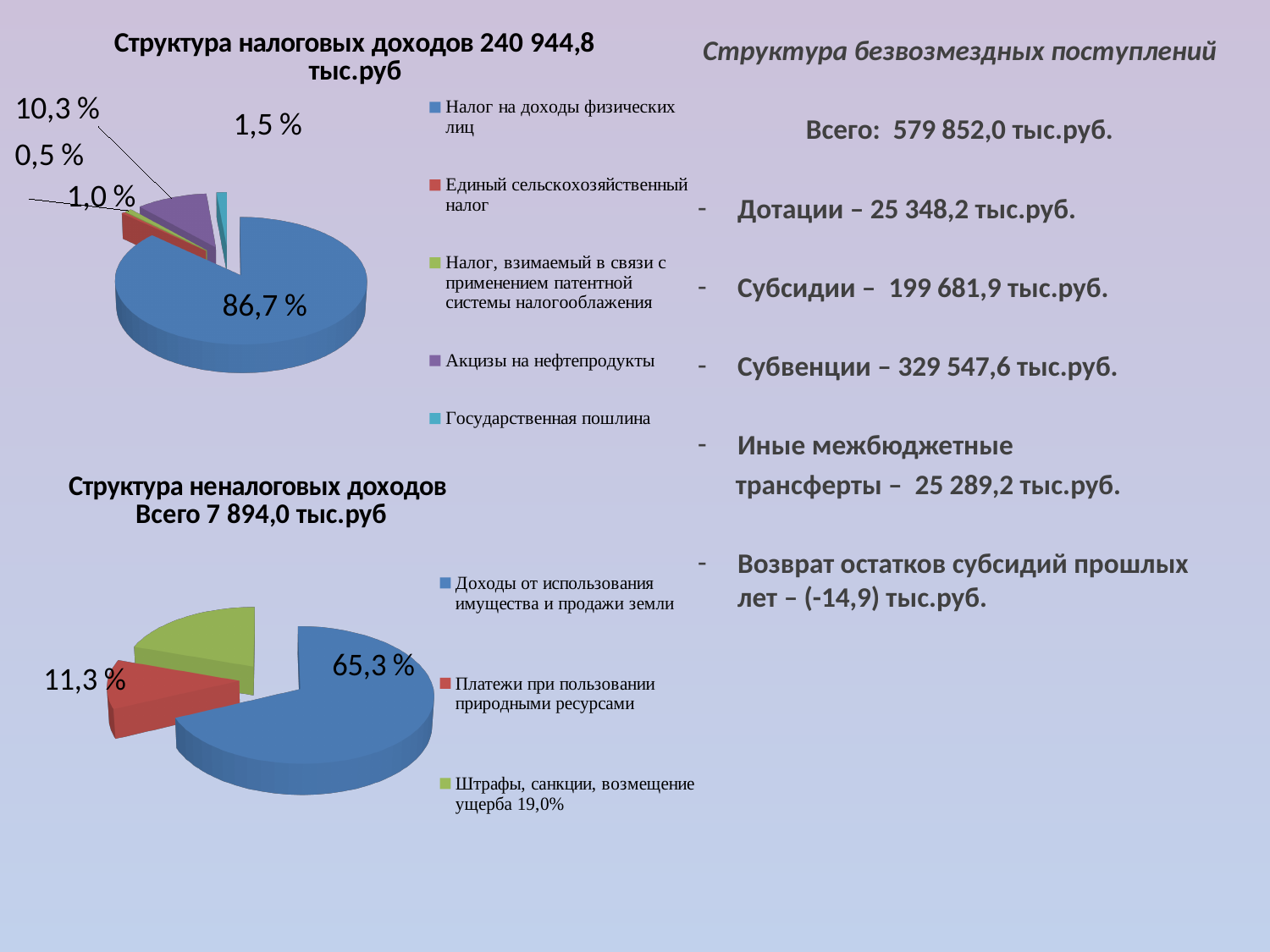
In the chart 'Структура налоговых доходов', how many categories does the legend list? 5 In the chart 'Структура неналоговых доходов', which is larger: 'Штрафы, санкции, возмещение ущерба' or 'Платежи при пользовании природными ресурсами'? Штрафы, санкции, возмещение ущерба What total amount is stated in the title of the chart 'Структура неналоговых доходов'? 7 894,0 тыс.руб In the chart 'Структура неналоговых доходов', what share does 'Штрафы, санкции, возмещение ущерба' have? 19,0% In the chart 'Структура налоговых доходов', what share does 'Акцизы на нефтепродукты' have? 10,3 % In the chart 'Структура неналоговых доходов', which category has the smallest share? Платежи при пользовании природными ресурсами In the chart 'Структура налоговых доходов', what share does 'Налог на доходы физических лиц' have? 86,7 % What kind of chart is 'Структура налоговых доходов'? Pie chart In the chart 'Структура неналоговых доходов', what share does 'Доходы от использования имущества и продажи земли' have? 65,3 % In the chart 'Структура налоговых доходов', what is the difference between the shares of 'Налог на доходы физических лиц' and 'Акцизы на нефтепродукты'? 76,4 % In the chart 'Структура налоговых доходов', which category has the largest share? Налог на доходы физических лиц In the chart 'Структура неналоговых доходов', what share does 'Платежи при пользовании природными ресурсами' have? 11,3 %